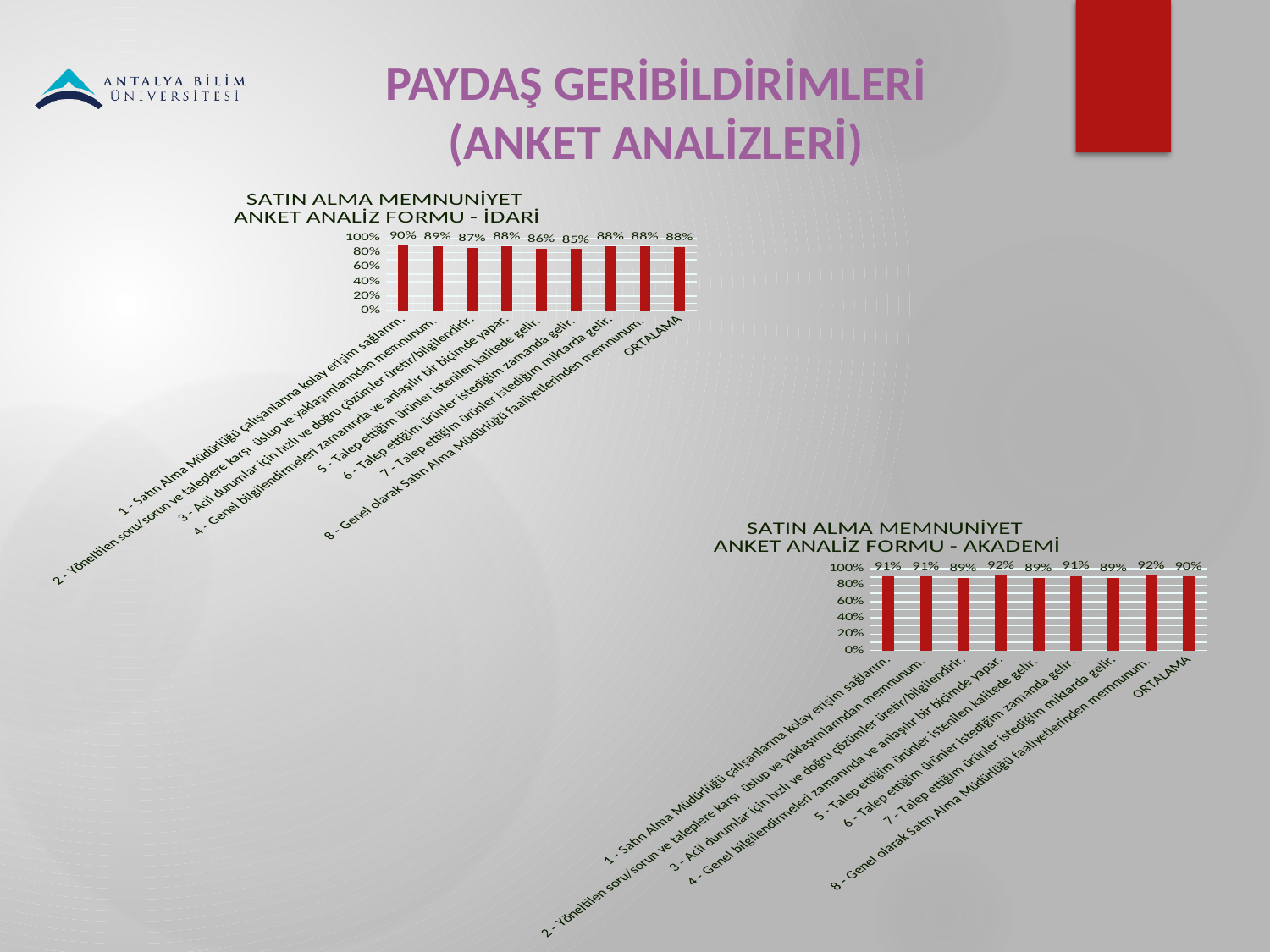
How many bars are plotted in the 'SATIN ALMA MEMNUNİYET ANKET ANALİZ FORMU - İDARİ' chart? 9 What type of chart is the 'SATIN ALMA MEMNUNİYET ANKET ANALİZ FORMU - AKADEMİ' chart? Bar chart What is the difference between the AKADEMİ value and the İDARİ value for item 8 (Genel olarak Satın Alma Müdürlüğü faaliyetlerinden memnunum)? 4% In the 'SATIN ALMA MEMNUNİYET ANKET ANALİZ FORMU - AKADEMİ' chart, is the value for item 1 greater or less than 80%? greater In the 'SATIN ALMA MEMNUNİYET ANKET ANALİZ FORMU - İDARİ' chart, which category has the lowest value? 6 - Talep ettiğim ürünler istediğim zamanda gelir. In the 'SATIN ALMA MEMNUNİYET ANKET ANALİZ FORMU - İDARİ' chart, what is the value for ORTALAMA? 88% Which is larger: the ORTALAMA value in the İDARİ chart or the ORTALAMA value in the AKADEMİ chart? AKADEMİ (90%) In the 'SATIN ALMA MEMNUNİYET ANKET ANALİZ FORMU - İDARİ' chart, what is the value for item 6 (Talep ettiğim ürünler istediğim zamanda gelir)? 85% In the 'SATIN ALMA MEMNUNİYET ANKET ANALİZ FORMU - İDARİ' chart, which category has the highest value? 1 - Satın Alma Müdürlüğü çalışanlarına kolay erişim sağlarım. In the 'SATIN ALMA MEMNUNİYET ANKET ANALİZ FORMU - AKADEMİ' chart, what is the value for ORTALAMA? 90% In the 'SATIN ALMA MEMNUNİYET ANKET ANALİZ FORMU - İDARİ' chart, what is the difference between the value for item 1 and the value for item 6? 5% In the 'SATIN ALMA MEMNUNİYET ANKET ANALİZ FORMU - AKADEMİ' chart, what is the value for item 4 (Genel bilgilendirmeleri zamanında ve anlaşılır bir biçimde yapar)? 92%